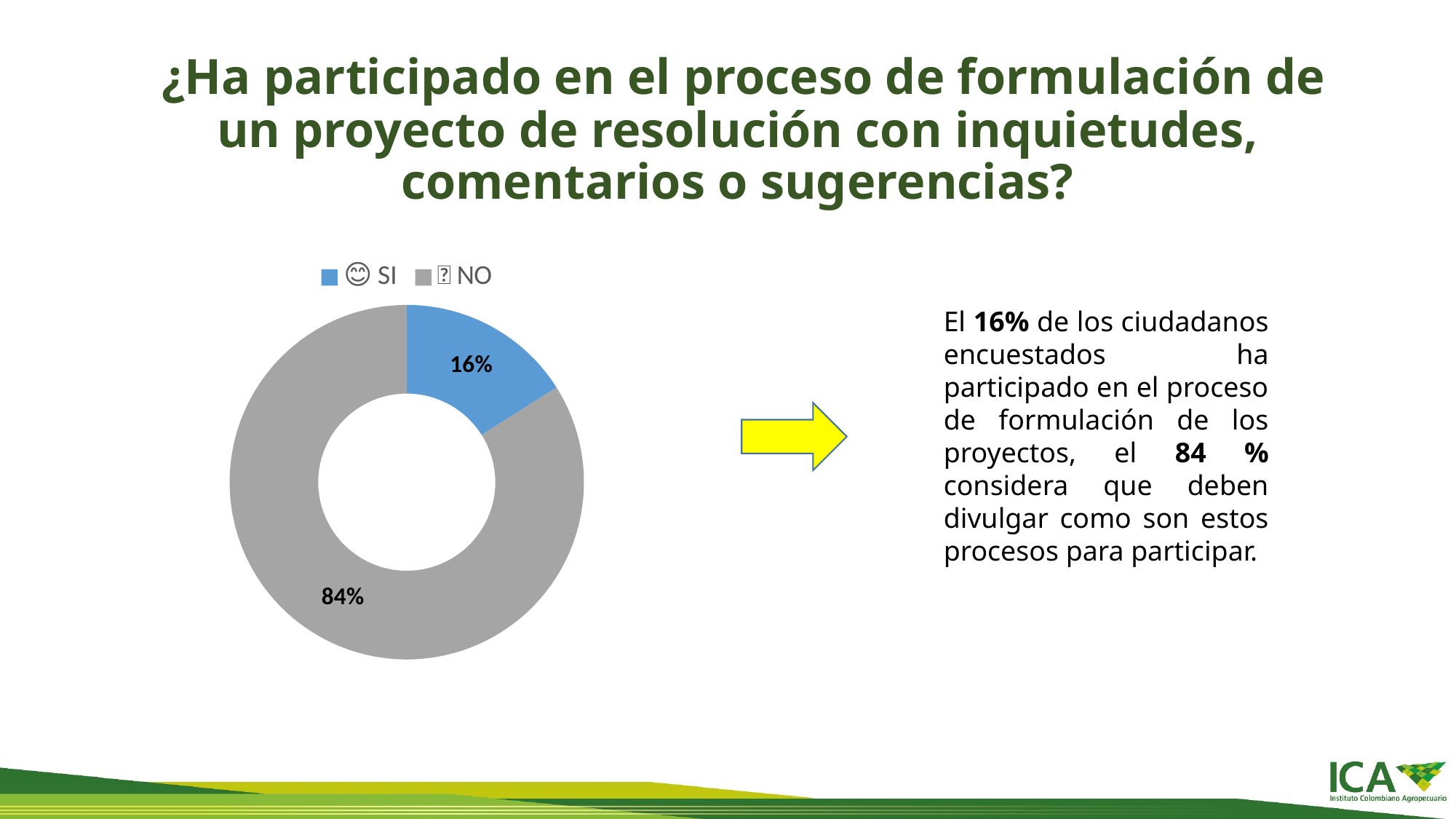
What kind of chart is shown on the slide? Pie chart (doughnut) What percentage of the pie chart is labelled NO? 84% Which slice is larger, SI or NO? NO What colour is the SI slice in the pie chart? Blue What colour is the NO slice in the pie chart? Grey What is the difference in percentage points between the NO and SI slices? 68 How many slices does the pie chart have? 2 How many entries does the chart legend list? 2 Which category has the largest share of the pie chart? NO What share of the pie does the SI slice represent? 16% Which category has the smallest share of the pie chart? SI What percentage of the pie chart is labelled SI? 16%